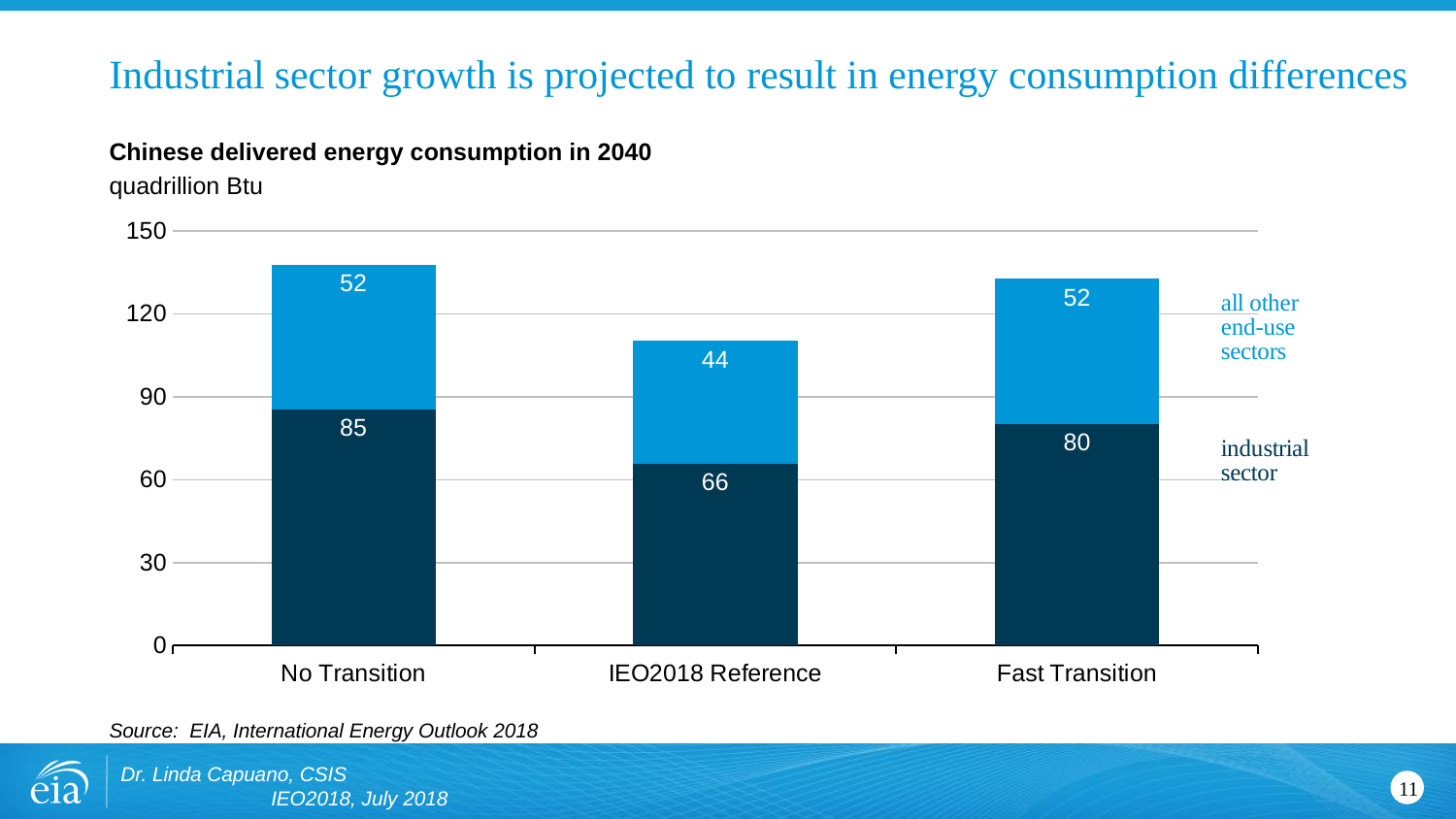
What is the total of the stacked bar for IEO2018 Reference? 110 Which case has the lowest industrial sector value? IEO2018 Reference What is the total of the stacked bar for No Transition? 137 How many cases are shown on the x axis? 3 Is the industrial sector value larger for Fast Transition or IEO2018 Reference? Fast Transition How many series does the chart show? 2 What is the industrial sector value for the No Transition case? 85 Which case has the highest industrial sector value? No Transition What is the all other end-use sectors value for the IEO2018 Reference case? 44 What is the industrial sector value for the Fast Transition case? 80 What kind of chart is shown? Stacked bar chart What is the difference between the industrial sector values for No Transition and IEO2018 Reference? 19